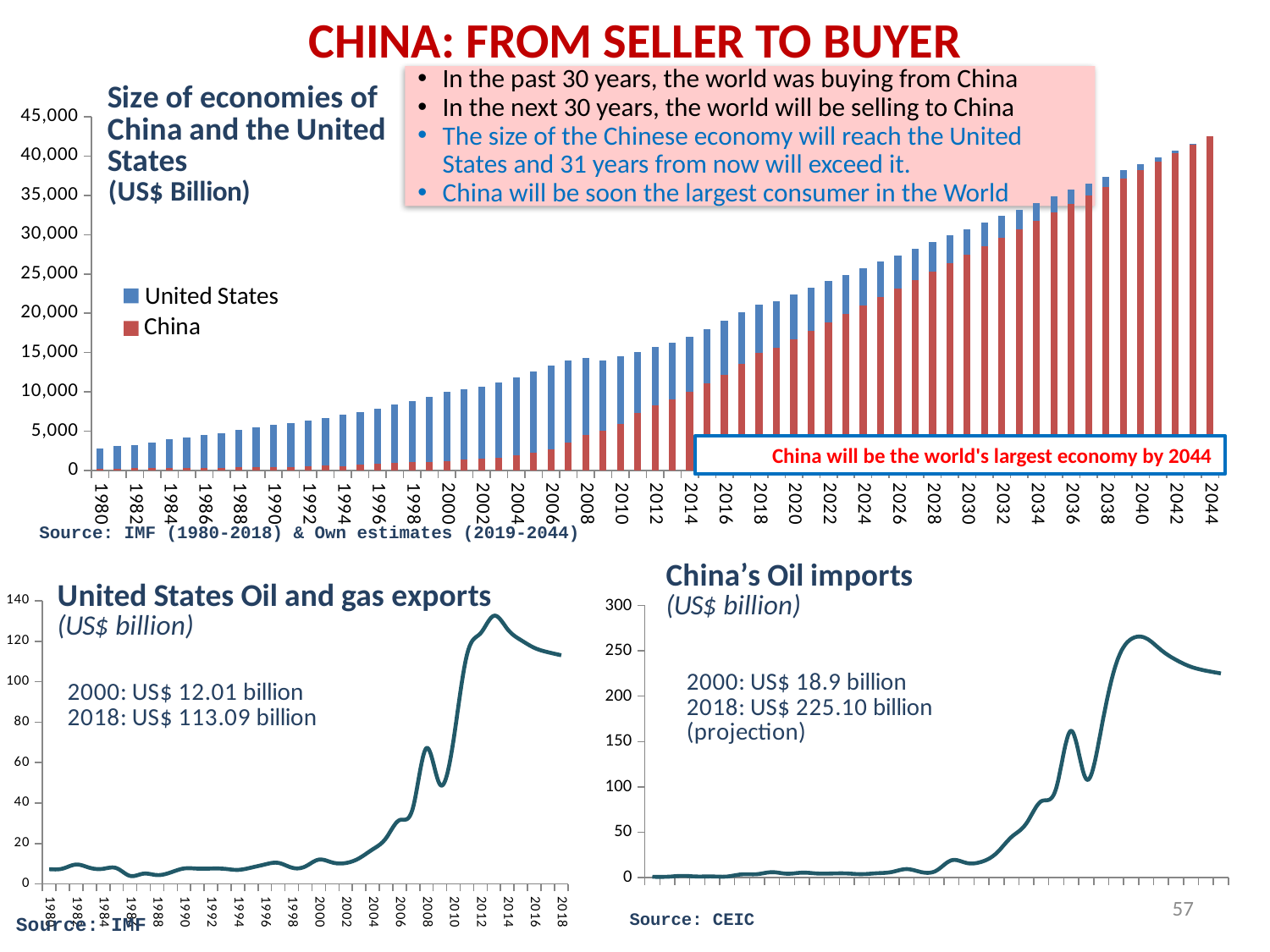
In the 'United States Oil and gas exports' chart, what was the value for 2018? US$ 113.09 billion In the 'Size of economies of China and the United States' chart, is the total stacked value for 2044 greater or less than 40,000? greater In the 'Size of economies of China and the United States' chart, is the total stacked value for 1980 greater or less than 5,000? less Which two series are shown in the legend of the 'Size of economies of China and the United States' chart? United States and China In the 'United States Oil and gas exports' chart, what is the difference between the 2018 and 2000 values? US$ 101.08 billion In the 'United States Oil and gas exports' chart, what was the value for 2000? US$ 12.01 billion In the 'China's Oil imports' chart, what is the value for 2018? US$ 225.10 billion What kind of chart is the 'Size of economies of China and the United States' chart? bar chart What kind of chart is the 'United States Oil and gas exports' chart? line chart How many series does the legend of the 'Size of economies of China and the United States' chart list? 2 In the 'Size of economies of China and the United States' chart, do the total stacked values rise or fall from 1980 to 2044? rise In the 'China's Oil imports' chart, is the peak value of the line greater or less than 250? greater